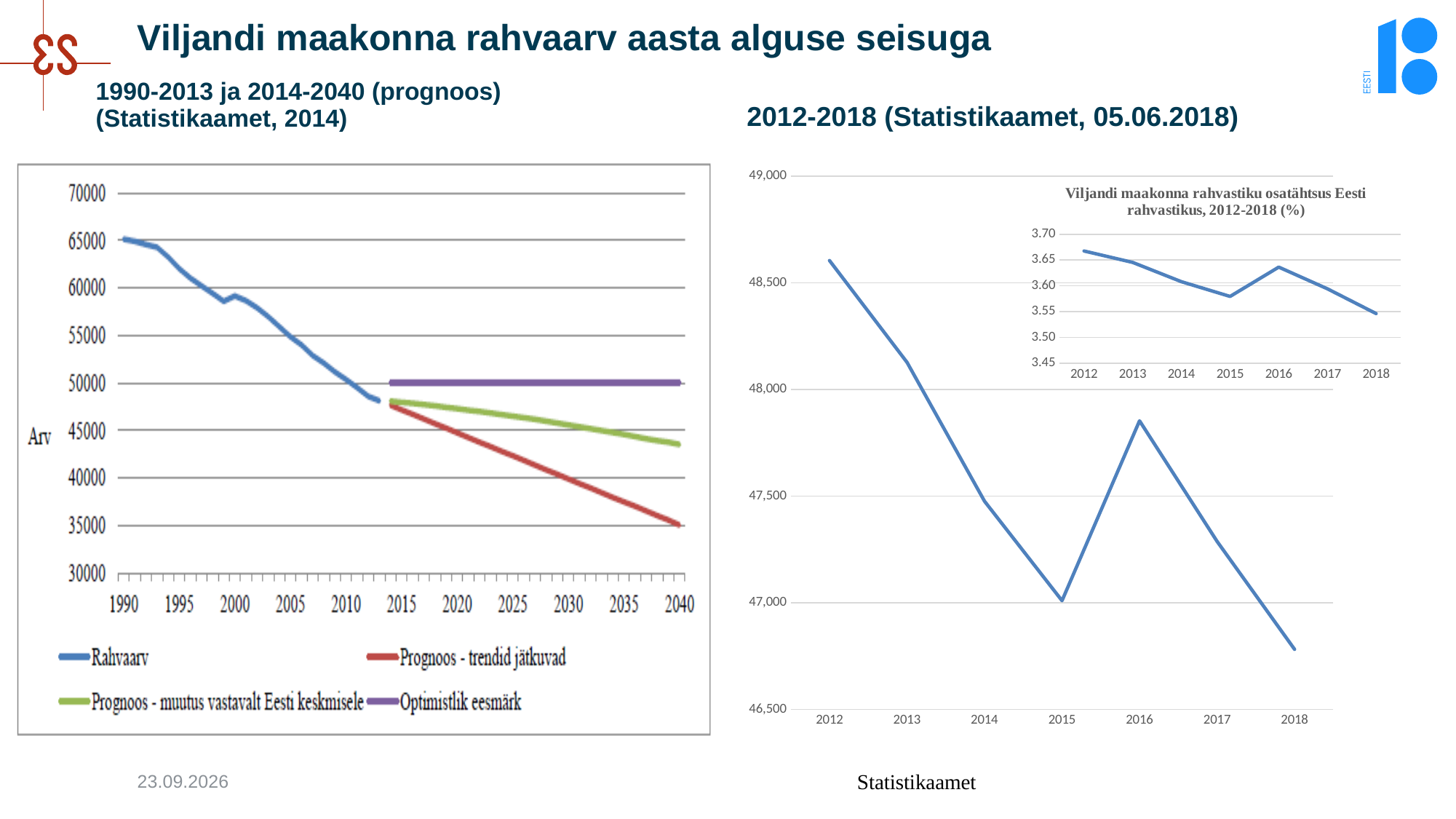
In the left chart (1990-2013 ja 2014-2040 prognoos), is the value of Prognoos - trendid jätkuvad in 2040 greater or less than 40000? less What kind of chart is the left chart (1990-2013 ja 2014-2040 prognoos)? line chart In the large right chart (2012-2018, Statistikaamet 05.06.2018), which year has the lowest value? 2018 In the left chart (1990-2013 ja 2014-2040 prognoos), is the Rahvaarv value for 1990 greater or less than 60000? greater In the large right chart (2012-2018, Statistikaamet 05.06.2018), which is larger, the value for 2015 or 2016? 2016 In the inset chart 'Viljandi maakonna rahvastiku osatähtsus Eesti rahvastikus, 2012-2018 (%)', is the value for 2015 greater or less than 3.60? less In the inset chart 'Viljandi maakonna rahvastiku osatähtsus Eesti rahvastikus, 2012-2018 (%)', which year has the highest value? 2012 How many series does the legend of the left chart (1990-2013 ja 2014-2040 prognoos) list? 4 How many years are plotted on the x axis of the large right chart (2012-2018, Statistikaamet 05.06.2018)? 7 In the left chart (1990-2013 ja 2014-2040 prognoos), which forecast series is lowest in 2040? Prognoos - trendid jätkuvad In the left chart (1990-2013 ja 2014-2040 prognoos), does the Rahvaarv series rise or fall from 1990 to 2013? fall